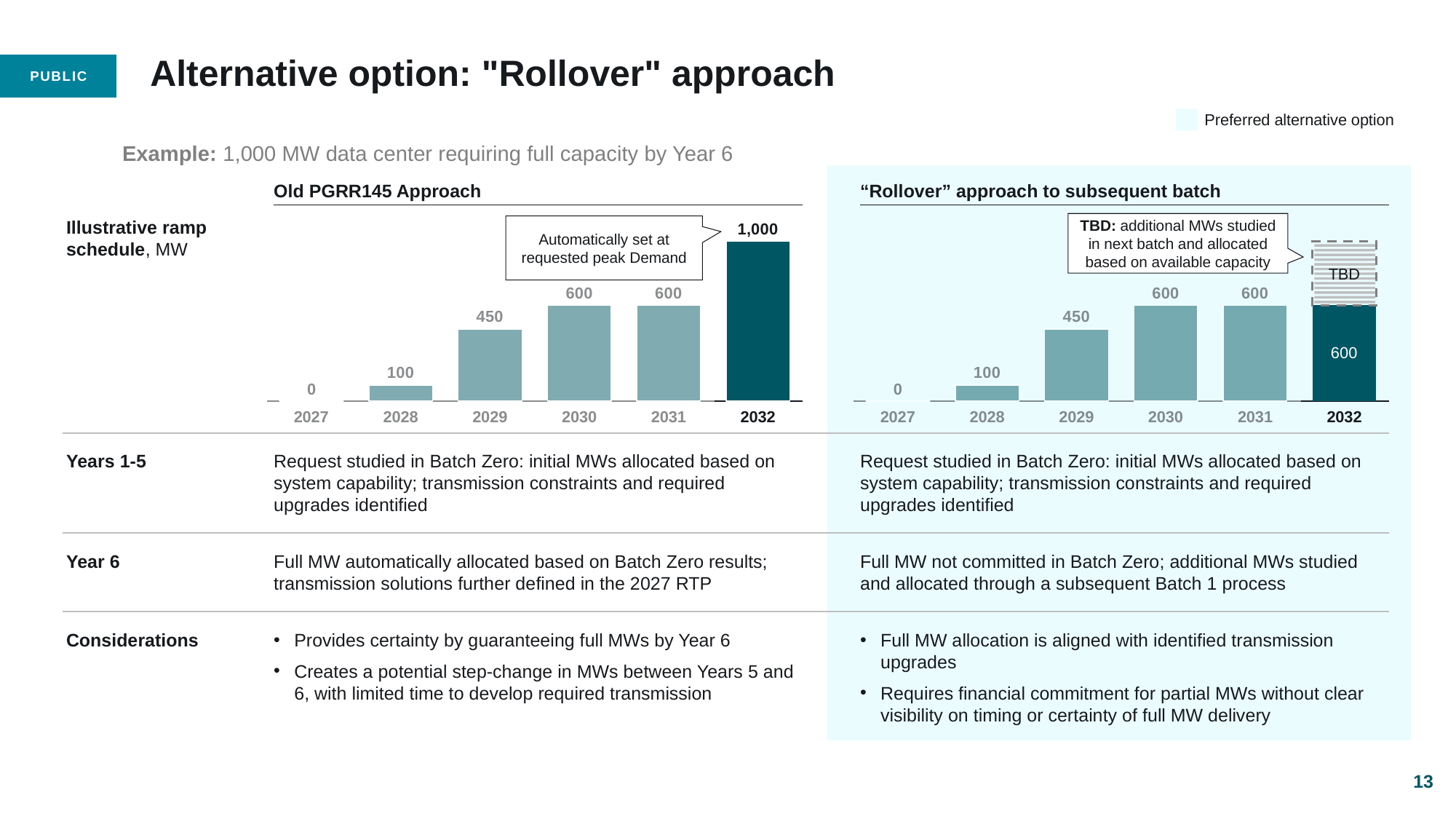
In the "Rollover" approach chart, what is the committed value shown for 2032? 600 In the "Old PGRR145 Approach" chart, what is the value for 2032? 1,000 In the "Rollover" approach chart, what is the value for 2028? 100 In the "Old PGRR145 Approach" chart, what is the difference between the 2032 value and the 2031 value? 400 How many years are shown on the x axis of the "Old PGRR145 Approach" chart? 6 What kind of chart is the "Rollover" approach chart? Bar chart In the "Old PGRR145 Approach" chart, which is larger, the value for 2029 or the value for 2030? 2030 In the "Rollover" approach chart, what label is shown on the dashed segment above the 2032 bar? TBD In the "Rollover" approach chart, what is the difference between the 2029 value and the 2028 value? 350 In the "Old PGRR145 Approach" chart, which year has the lowest value? 2027 In the "Old PGRR145 Approach" chart, which year has the highest value? 2032 In the "Old PGRR145 Approach" chart, what is the value for 2029? 450